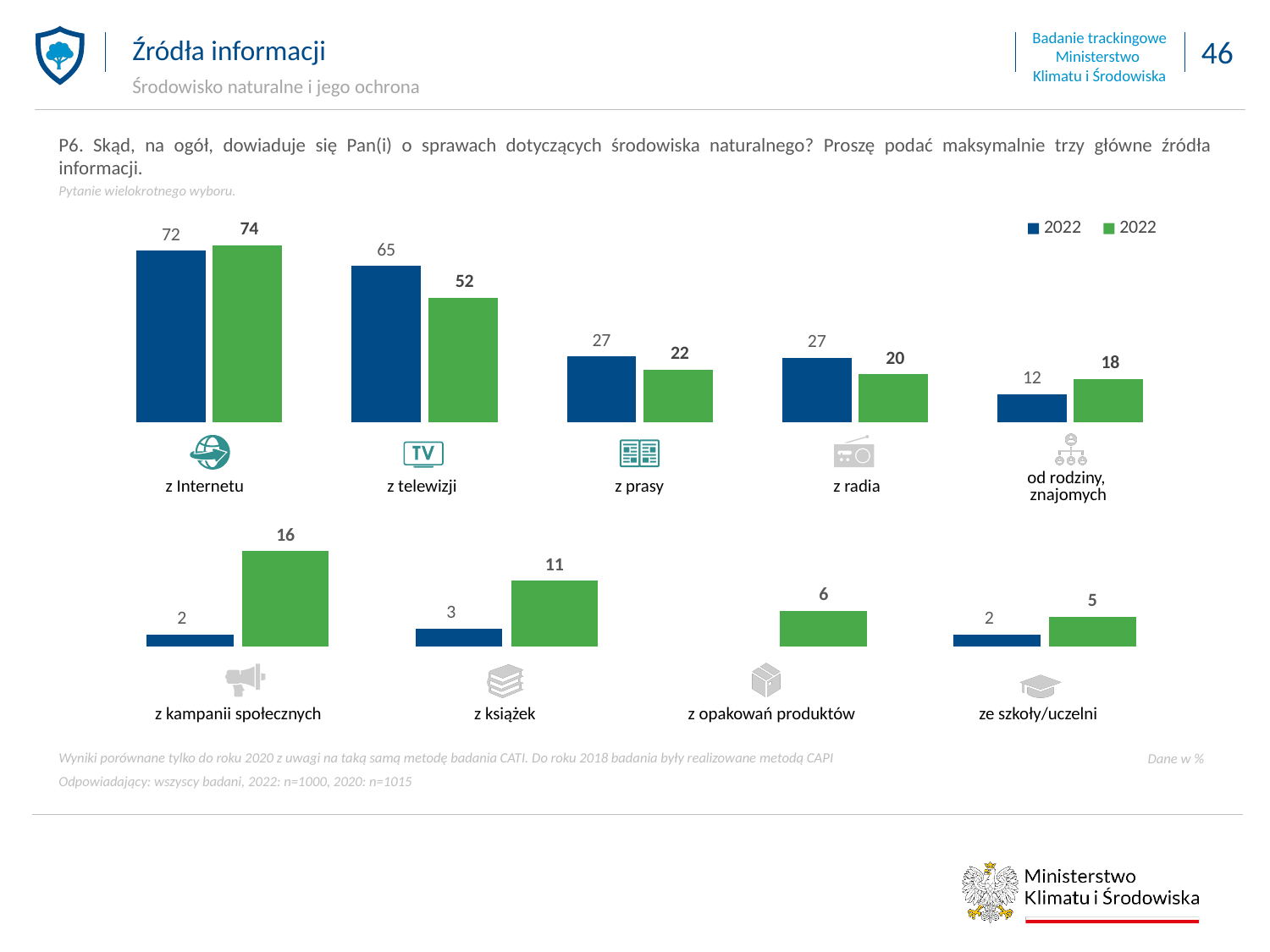
How many series does the legend list? 2 Which category has the lowest green bar? ze szkoły/uczelni How many source categories are shown in the chart? 9 What is the value of the blue bar for "z telewizji"? 65 What kind of chart is shown on the slide? bar chart For "z radia", which bar is larger, the blue one or the green one? the blue one What is the value of the green bar for "z Internetu"? 74 What is the value of the blue bar for "z kampanii społecznych"? 2 What is the value of the green bar for "od rodziny, znajomych"? 18 What is the difference between the green and blue bars for "z kampanii społecznych"? 14 Which category has the highest green bar? z Internetu What is the difference between the blue and green bars for "z telewizji"? 13